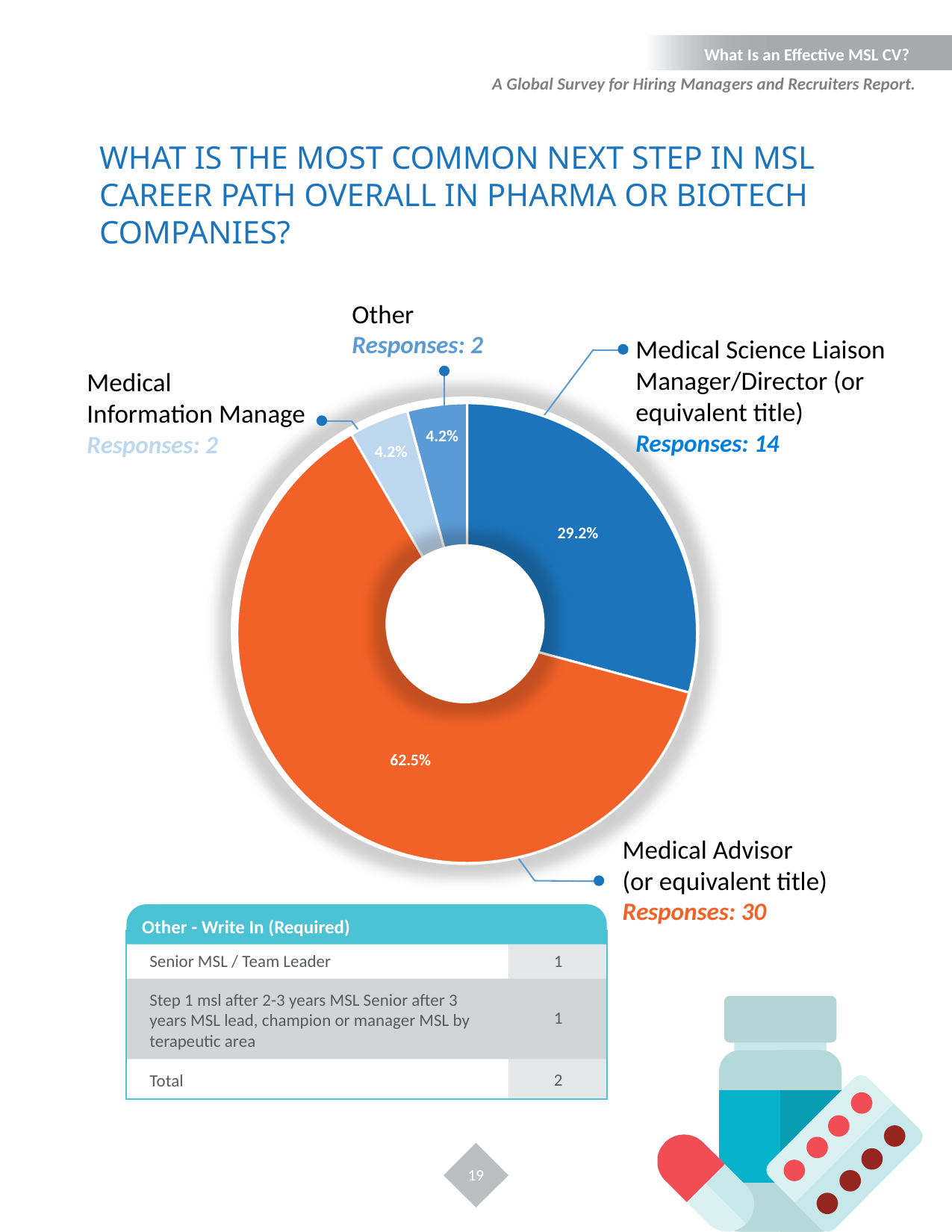
How many categories are shown in the pie chart? 4 Which received more responses: Medical Information Manage or Medical Science Liaison Manager/Director (or equivalent title)? Medical Science Liaison Manager/Director (or equivalent title) What colour is the Medical Advisor (or equivalent title) slice in the pie chart? Orange What percentage share does the Other slice have in the pie chart? 4.2% Which category has the largest slice of the pie chart? Medical Advisor (or equivalent title) What percentage share does Medical Advisor (or equivalent title) have in the pie chart? 62.5% How many responses did Medical Science Liaison Manager/Director (or equivalent title) receive? 14 What percentage share does Medical Science Liaison Manager/Director (or equivalent title) have in the pie chart? 29.2% How many responses did Other receive? 2 What is the difference in responses between Medical Advisor (or equivalent title) and Medical Science Liaison Manager/Director (or equivalent title)? 16 What kind of chart is shown on the slide? Pie chart (doughnut) How many responses did Medical Advisor (or equivalent title) receive? 30